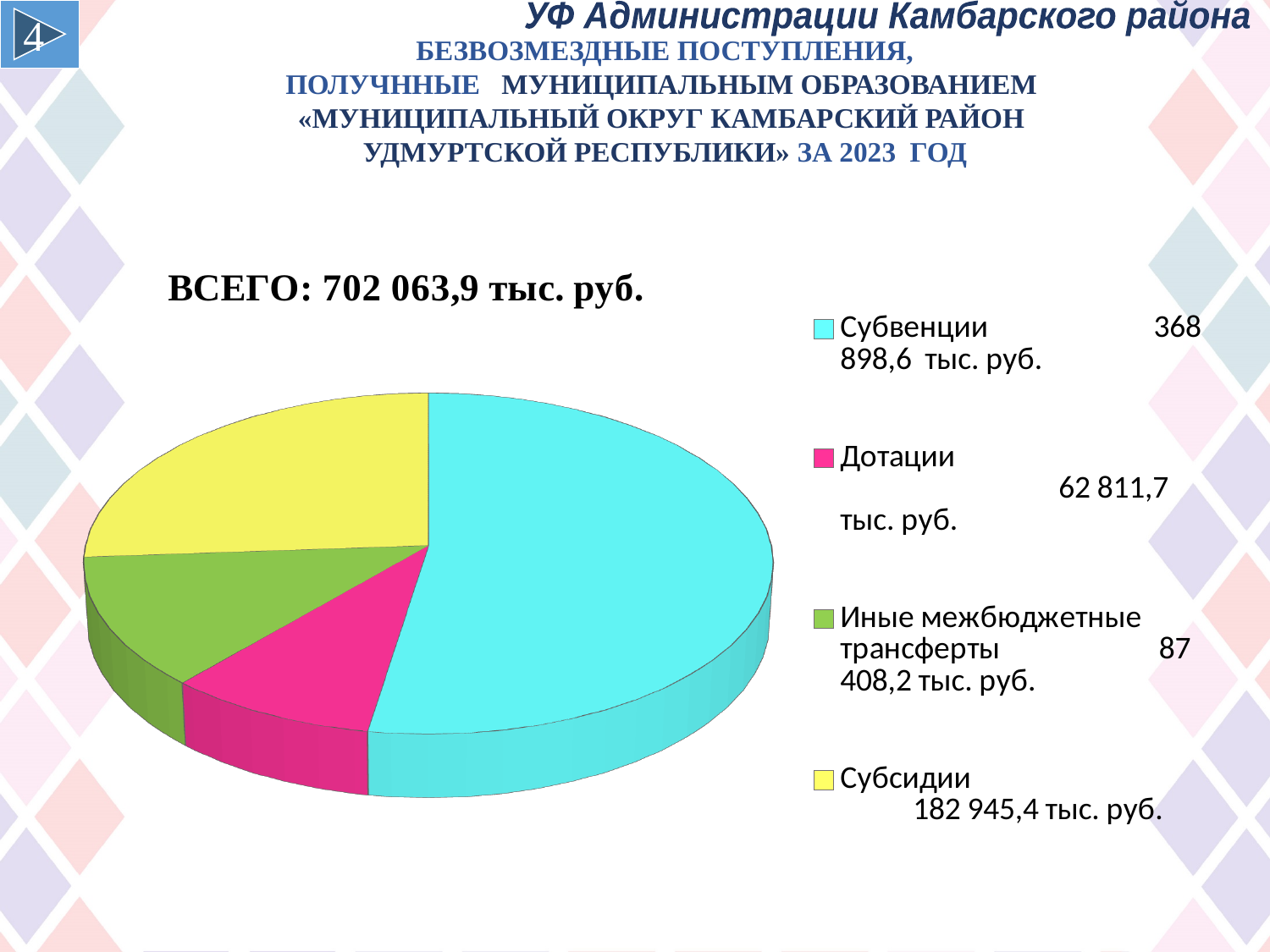
What colour is the slice for Субсидии? Yellow What is the value shown for Субвенции? 368 898,6 тыс. руб. What is the difference between the values for Субвенции and Субсидии? 185 953,2 тыс. руб. How many slices does the pie chart have? 4 Which is larger, Субсидии or Иные межбюджетные трансферты? Субсидии What is the value shown for Субсидии? 182 945,4 тыс. руб. What is the value shown for Иные межбюджетные трансферты? 87 408,2 тыс. руб. Which category has the smallest slice of the pie? Дотации What total amount (ВСЕГО) is stated above the pie chart? 702 063,9 тыс. руб. What is the value shown for Дотации? 62 811,7 тыс. руб. Which category has the largest slice of the pie? Субвенции What kind of chart is shown on the slide? Pie chart